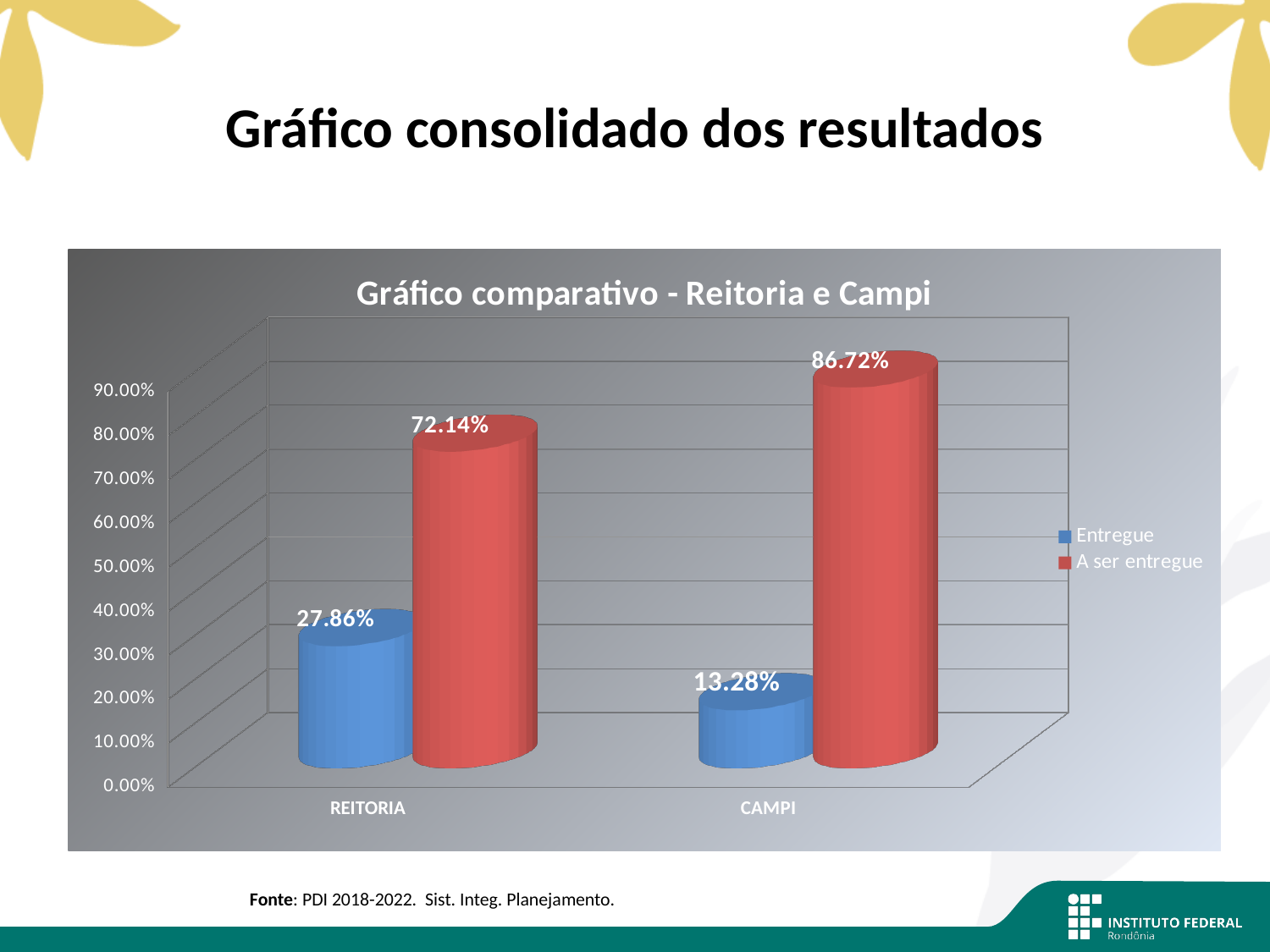
Which category has the lowest 'Entregue' value? CAMPI Which is larger: 'A ser entregue' for REITORIA or 'A ser entregue' for CAMPI? CAMPI What is the title of the chart? Gráfico comparativo - Reitoria e Campi What kind of chart is shown? Bar chart How many series does the legend list? 2 Which category has the highest 'A ser entregue' value? CAMPI How many categories are shown on the x axis? 2 What is the value of 'Entregue' for REITORIA? 27.86% What is the difference between the 'Entregue' values for REITORIA and CAMPI? 14.58% What is the value of 'A ser entregue' for CAMPI? 86.72% What is the value of 'Entregue' for CAMPI? 13.28% What is the value of 'A ser entregue' for REITORIA? 72.14%